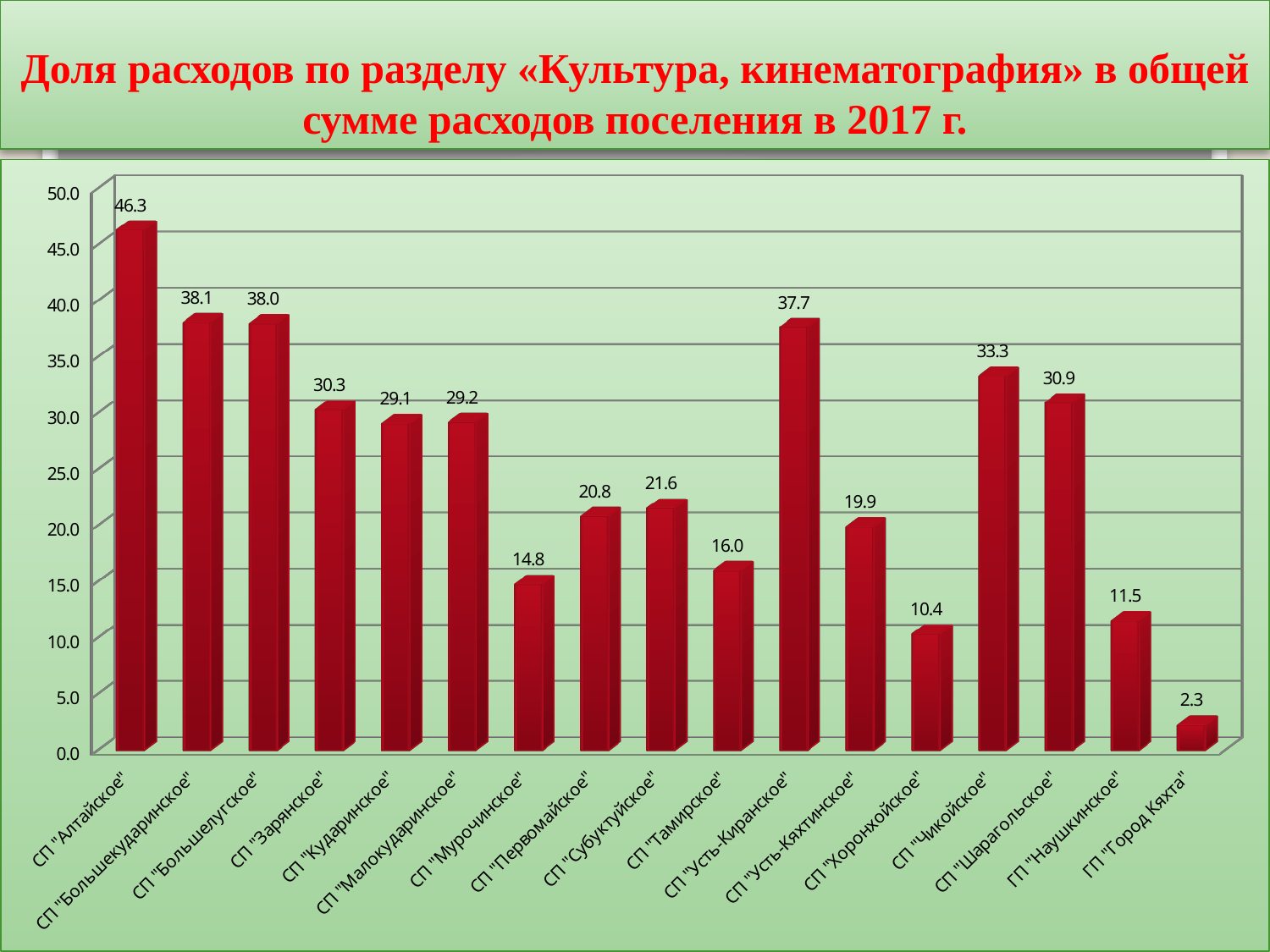
What is the value for ГП "Наушкинское"? 11.5 Which category has the lowest value? ГП "Город Кяхта" What is the value for СП "Усть-Киранское"? 37.7 What kind of chart is shown on the slide? bar chart What is the difference between the values for СП "Чикойское" and СП "Шарагольское"? 2.4 What is the difference between the values for СП "Большекударинское" and СП "Большелугское"? 0.1 Which is larger, the value for СП "Первомайское" or СП "Субуктуйское"? СП "Субуктуйское" What is the value for СП "Хоронхойское"? 10.4 Is the value for СП "Тамирское" greater or less than 20.0? less Which category has the highest value? СП "Алтайское" How many categories are shown on the chart? 17 What is the value for СП "Алтайское"? 46.3